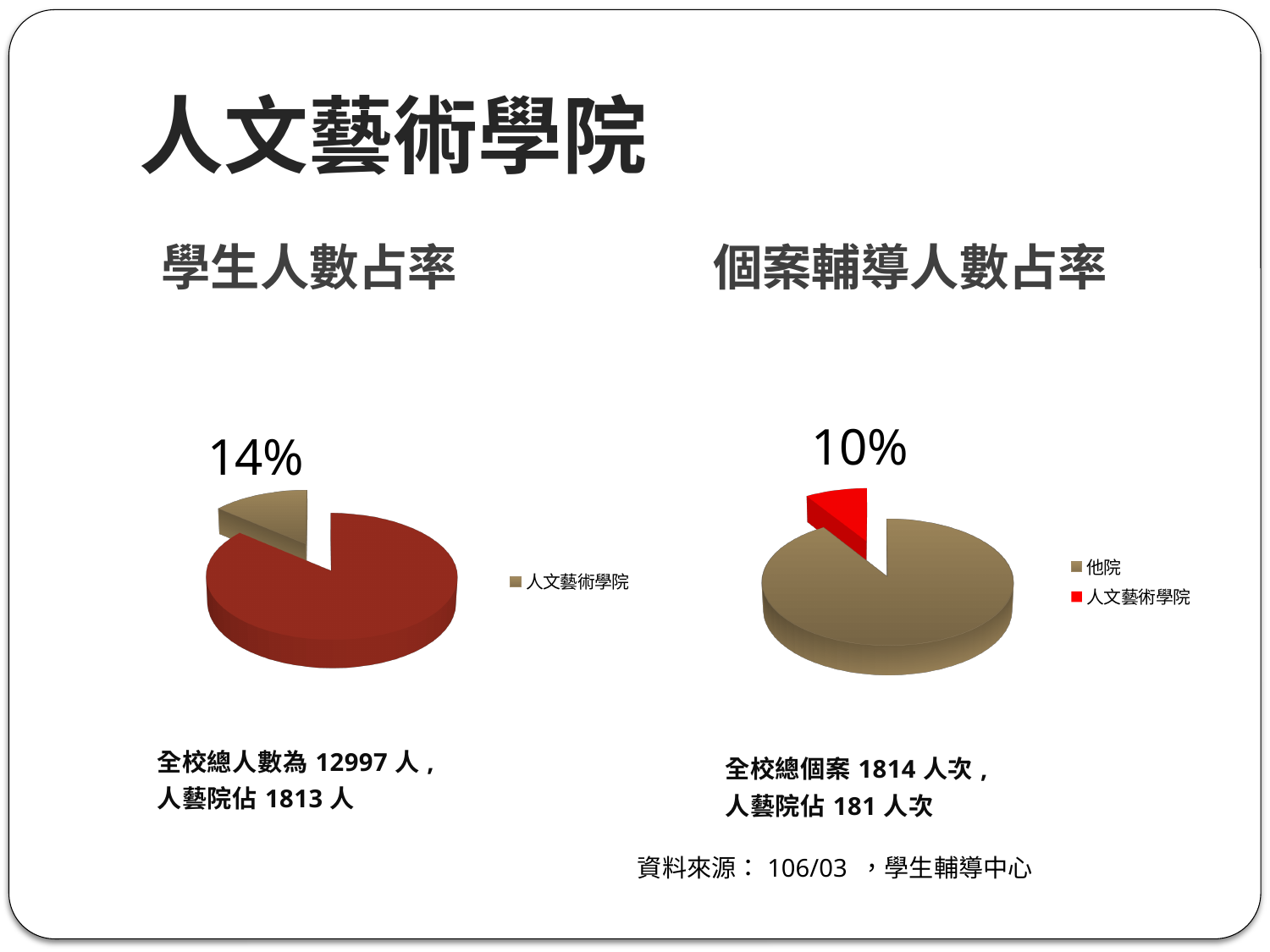
What kind of chart is the 學生人數占率 chart? pie chart Is the 人文藝術學院 share larger in the 學生人數占率 chart or in the 個案輔導人數占率 chart? 學生人數占率 How many entries does the legend of the 學生人數占率 chart list? 1 What kind of chart is the 個案輔導人數占率 chart? pie chart What is the title of the pie chart on the right of the slide? 個案輔導人數占率 In the 個案輔導人數占率 chart, what share is labelled for 人文藝術學院? 10% In the 個案輔導人數占率 chart, which slice is larger, 他院 or 人文藝術學院? 他院 How many entries does the legend of the 個案輔導人數占率 chart list? 2 How many slices does the 個案輔導人數占率 pie chart have? 2 In the 學生人數占率 chart, what share is labelled for 人文藝術學院? 14% In the 個案輔導人數占率 chart, what colour is the 人文藝術學院 slice? red How many slices does the 學生人數占率 pie chart have? 2